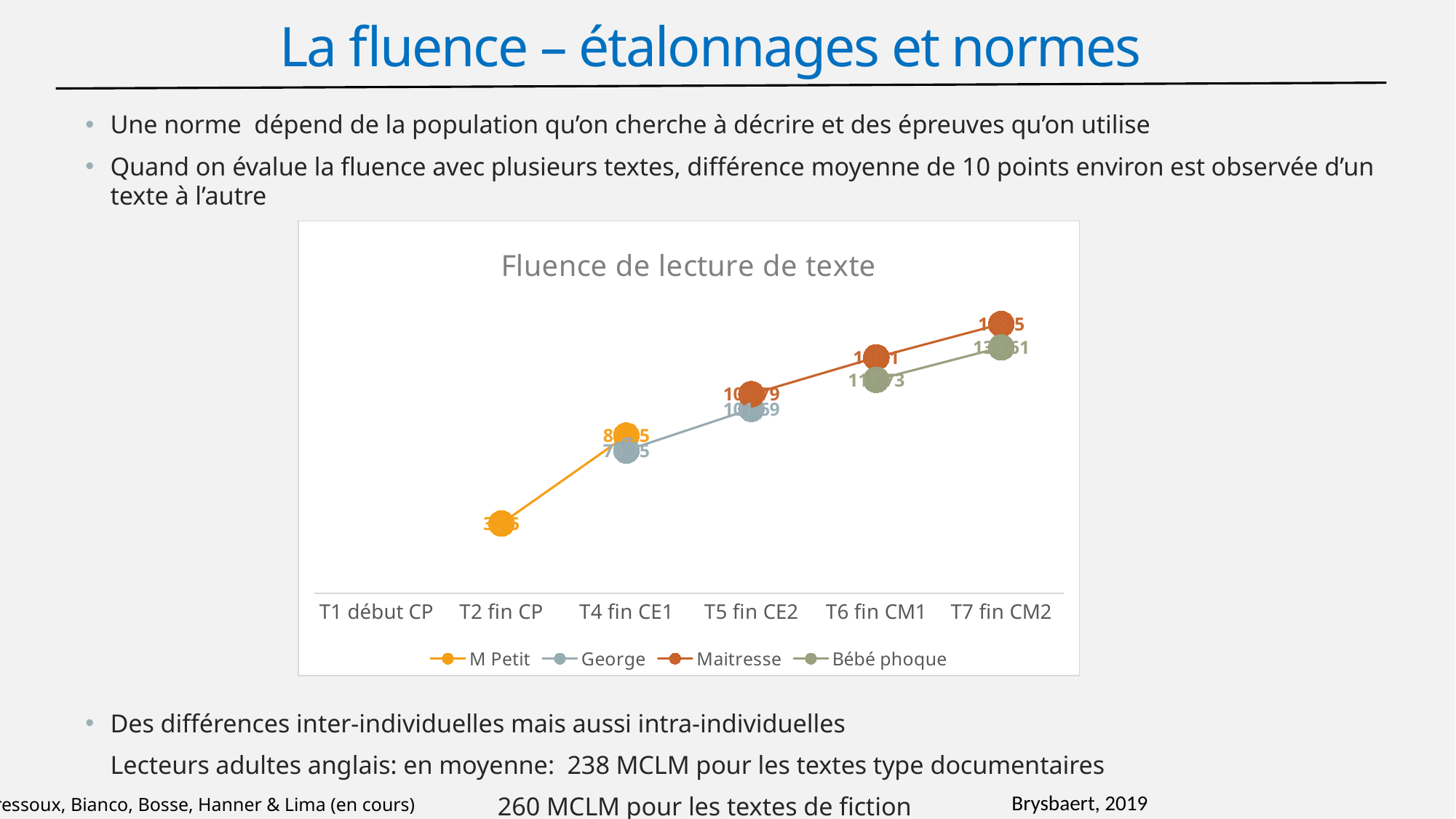
Do the plotted values rise or fall from T2 fin CP to T7 fin CM2? Rise At T7 fin CM2, which series has the higher value, Maitresse or Bébé phoque? Maitresse At T5 fin CE2, which series has the higher value, Maitresse or George? Maitresse What is the title of the chart? Fluence de lecture de texte What kind of chart is shown on the slide? Line chart Which series are listed in the chart legend? M Petit, George, Maitresse, Bébé phoque At T4 fin CE1, which series has the higher value, M Petit or George? M Petit How many series does the chart legend list? 4 How many categories are shown on the x axis of the chart? 6 Which series is plotted at T2 fin CP? M Petit Which category has the highest plotted value in the chart? T7 fin CM2 Which category has the lowest plotted value in the chart? T2 fin CP